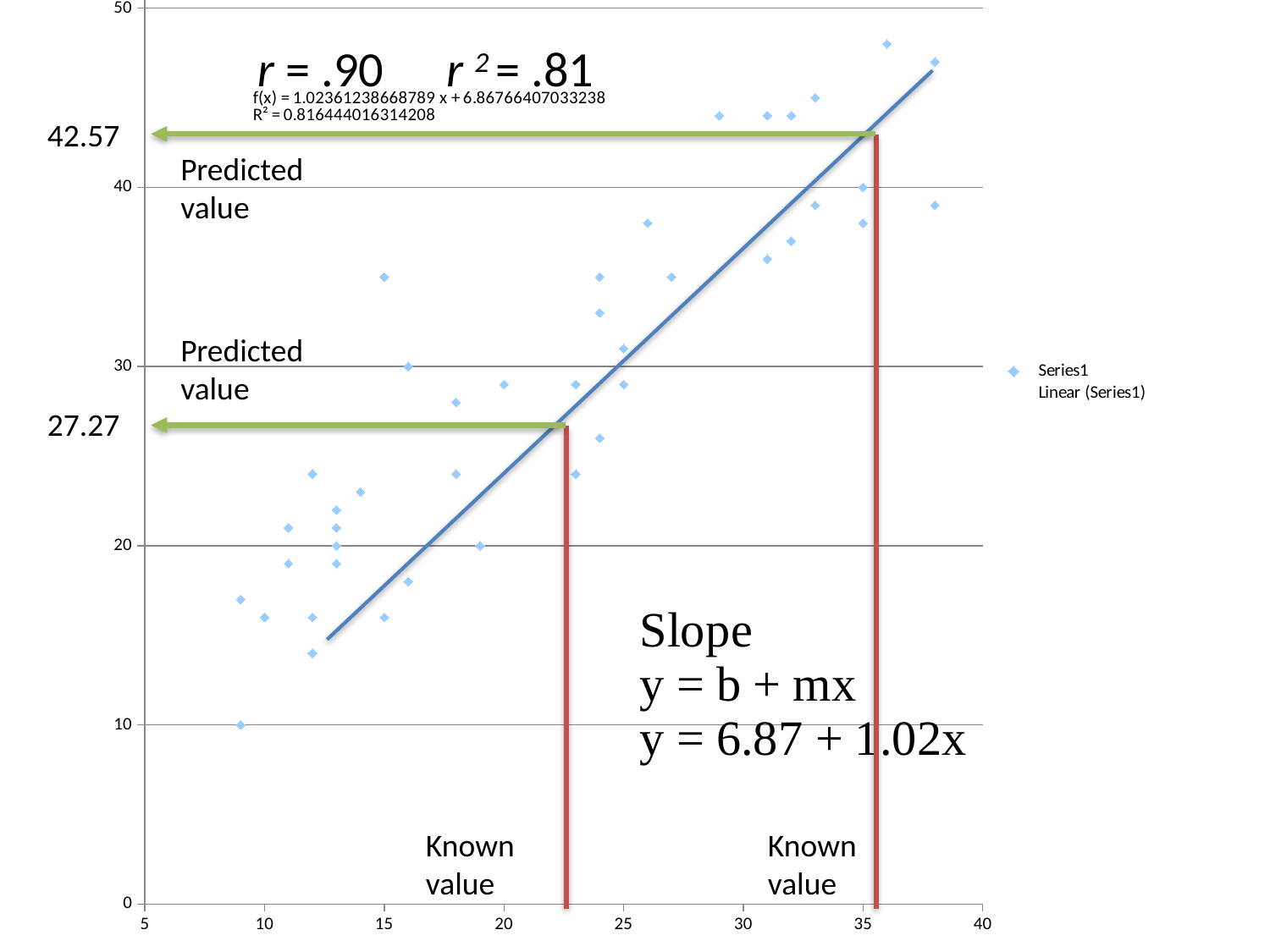
Is the trendline value at x = 35 greater or less than 40? greater What is the maximum value shown on the vertical axis of the chart? 50 What are the two entries in the chart legend? Series1 and Linear (Series1) What predicted value is shown for the lower green arrow on the chart? 27.27 According to the slope equation on the slide, what is the intercept b in y = b + mx? 6.87 What R² value is printed on the chart for the trendline? 0.816444016314208 Does the fitted trendline rise or fall as x increases? rises What predicted value is shown for the upper green arrow on the chart? 42.57 How many entries does the chart legend list? 2 What is the difference between the two predicted values shown on the chart, 42.57 and 27.27? 15.30 What kind of chart is shown on the slide? scatter chart What is the value of r shown on the slide? .90